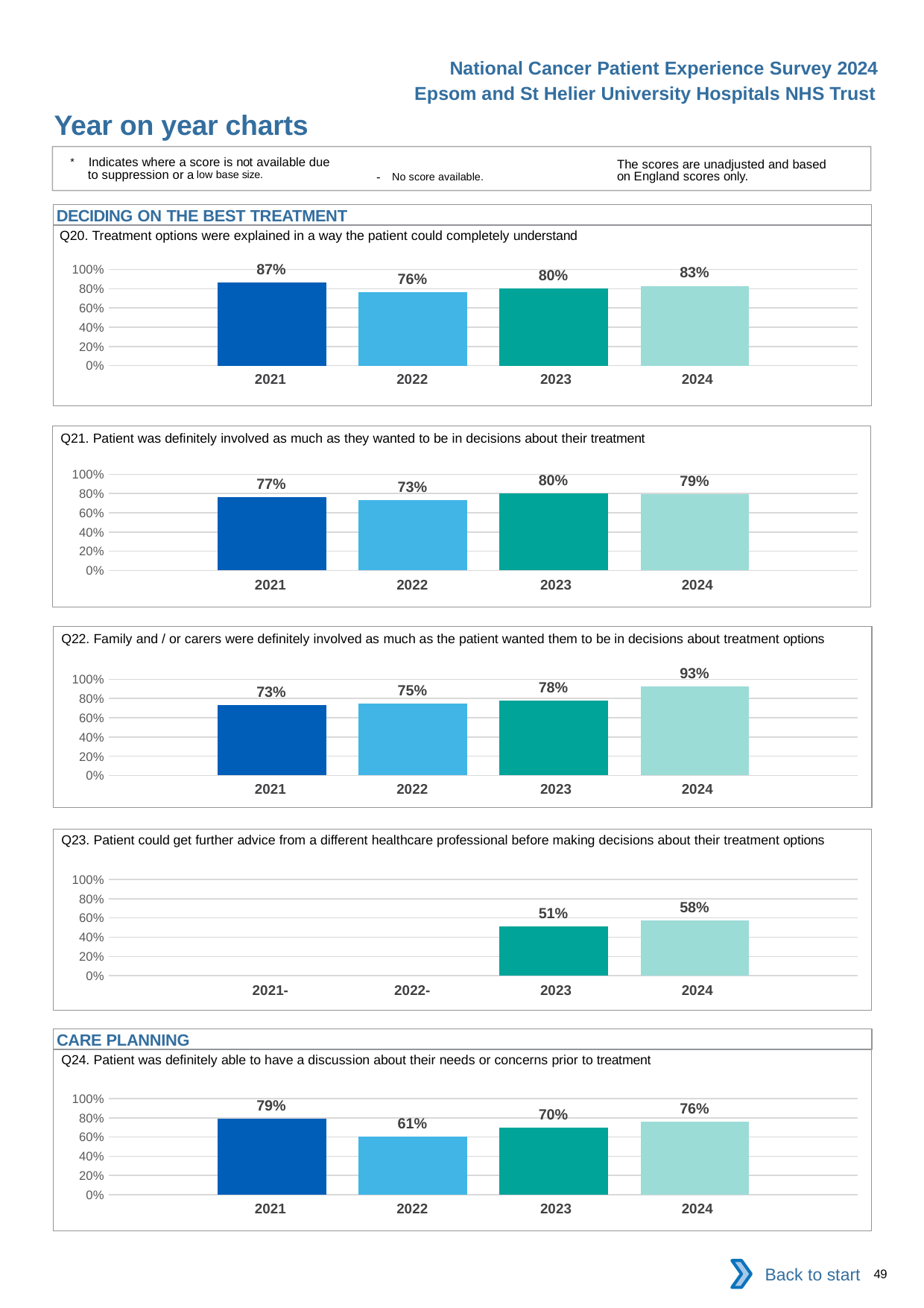
In the Q24 chart, which is larger, the value for 2021 or the value for 2024? 2021 In the Q23 chart, is the value for 2024 greater or less than 60%? less In the Q21 chart, what is the difference between the 2023 and 2022 values? 7% In the Q23 chart, how many years have a score shown? 2 In the Q22 chart, what is the value for 2024? 93% Which section heading appears above the Q24 chart? CARE PLANNING In the Q20 chart, which year has the lowest value? 2022 In the Q22 chart, do the values rise or fall from 2021 to 2024? rise In the Q21 chart, which year has the highest value? 2023 In the Q20 chart, what is the value for 2021? 87% In the Q24 chart, what is the value for 2022? 61% What kind of chart is the Q24 chart? bar chart